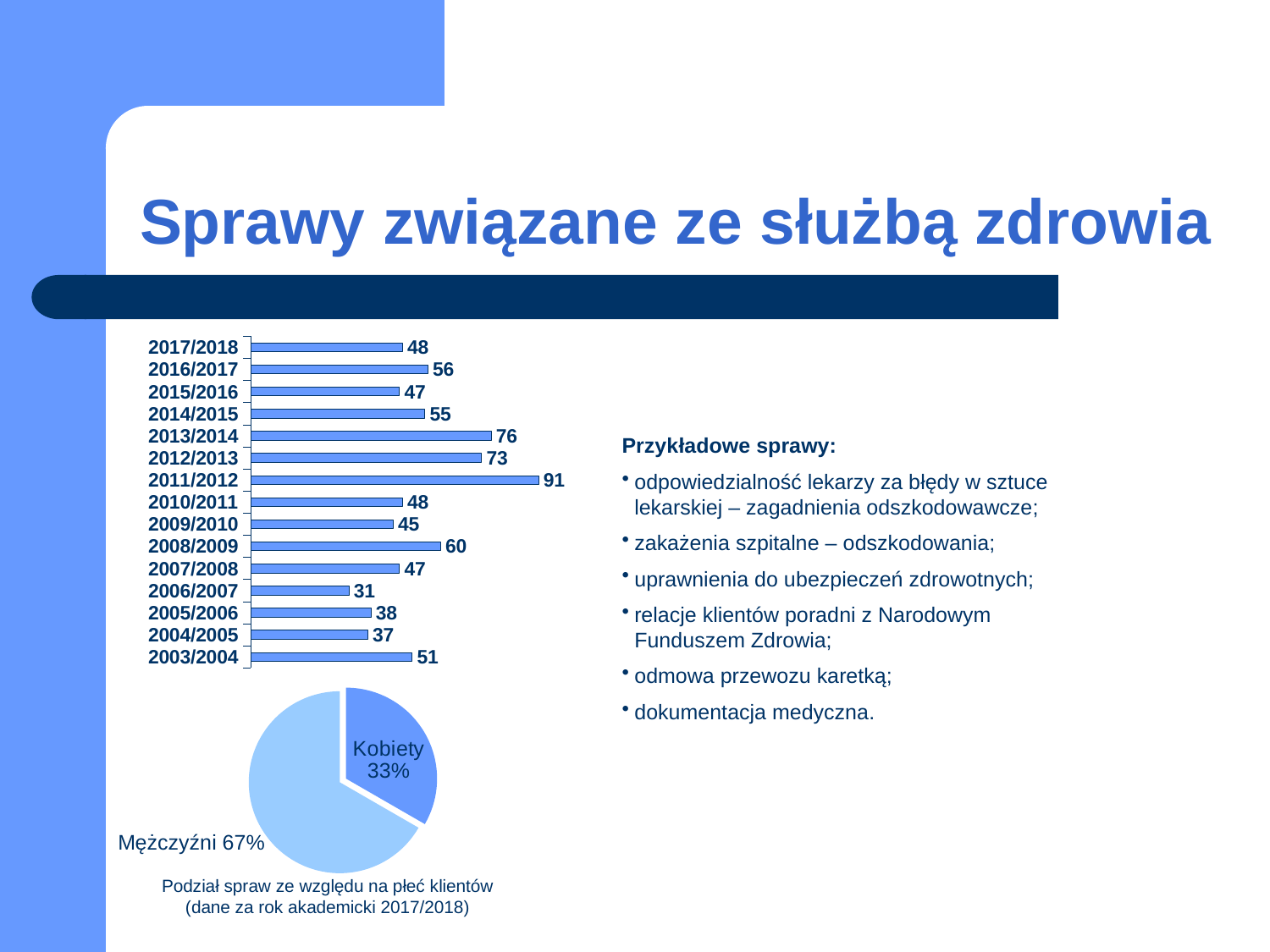
How many academic years are shown in the bar chart at the top left of the slide? 15 In the bar chart at the top left of the slide, what is the difference between the values for 2013/2014 and 2012/2013? 3 In the pie chart at the bottom left of the slide, what share is labelled Kobiety? 33% In the bar chart at the top left of the slide, what is the value for 2017/2018? 48 What kind of chart is the chart at the bottom left of the slide? pie chart In the bar chart at the top left of the slide, what is the value for 2011/2012? 91 In the bar chart at the top left of the slide, what is the value for 2006/2007? 31 In the bar chart at the top left of the slide, which academic year has the lowest value? 2006/2007 What kind of chart is the chart at the top left of the slide? bar chart In the bar chart at the top left of the slide, which is larger, the value for 2016/2017 or the value for 2014/2015? 2016/2017 In the bar chart at the top left of the slide, which academic year has the highest value? 2011/2012 In the pie chart at the bottom left of the slide, what share is labelled Mężczyźni? 67%